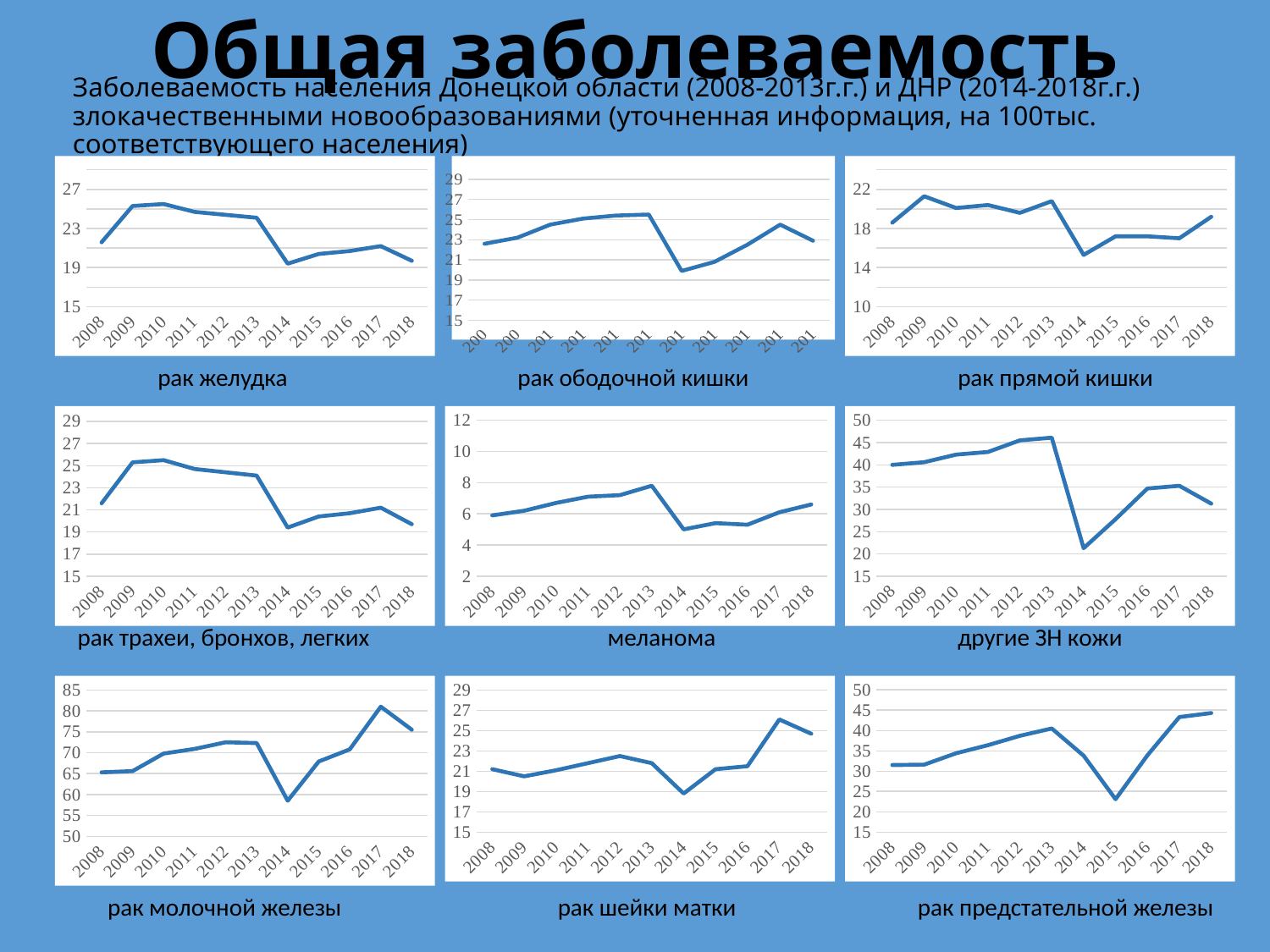
In the 'меланома' chart, which year has the highest value? 2013 In the 'рак шейки матки' chart, which is larger, the value for 2017 or the value for 2014? 2017 What type of chart is the 'рак желудка' chart? line chart In the 'рак молочной железы' chart, which year has the highest value? 2017 How many charts are shown on the slide? 9 In the 'рак желудка' chart, how many years are plotted on the x axis? 11 In the 'рак молочной железы' chart, is the value for 2014 greater or less than 60? less In the 'рак предстательной железы' chart, which year has the lowest value? 2015 In the 'другие ЗН кожи' chart, which year has the lowest value? 2014 In the 'рак прямой кишки' chart, which year has the lowest value? 2014 In the 'рак прямой кишки' chart, is the value for 2014 greater or less than 18? less In the 'рак желудка' chart, is the value for 2014 greater or less than 23? less